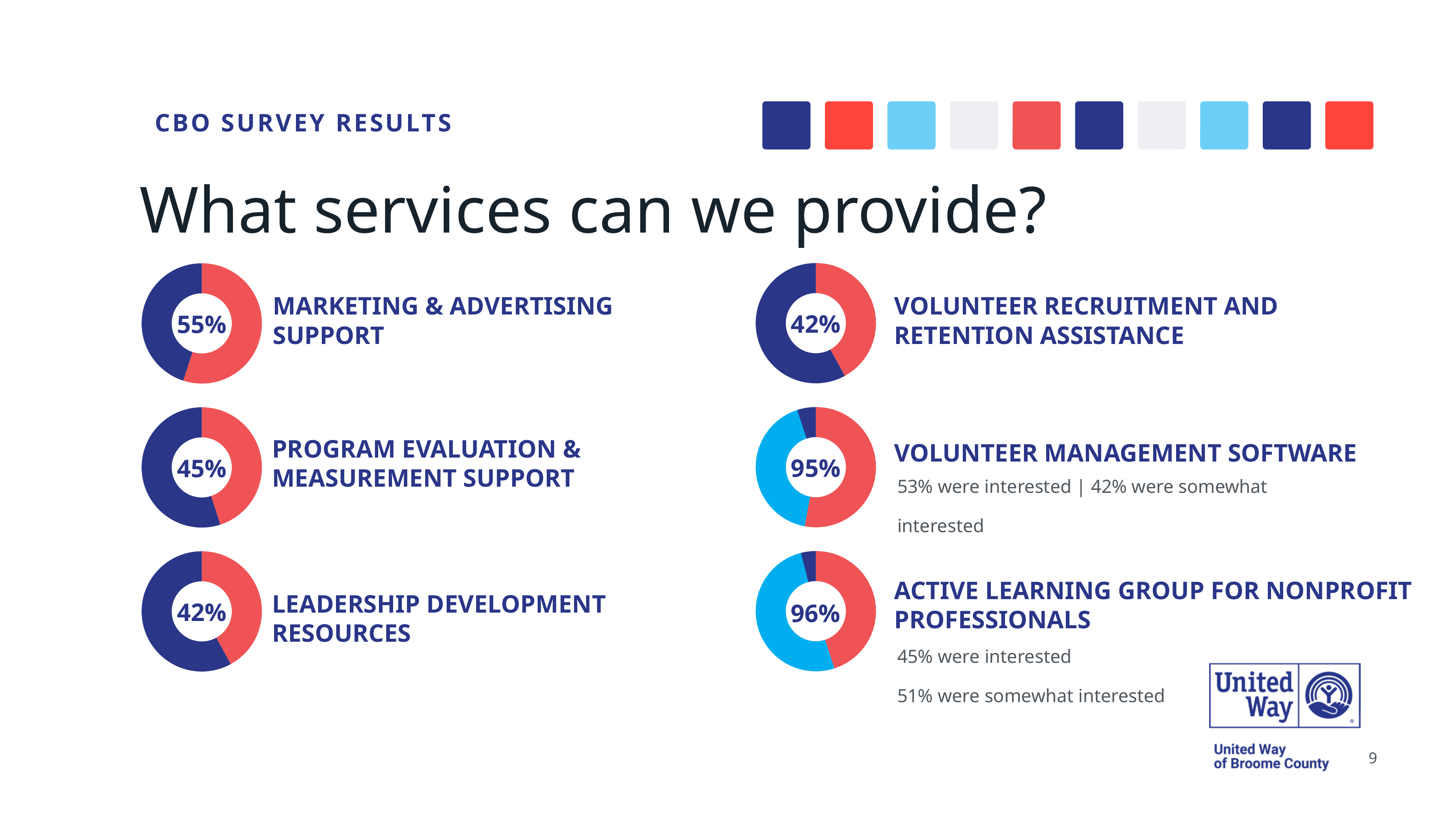
What percentage is shown in the centre of the Program Evaluation & Measurement Support donut chart? 45% For the Volunteer Management Software chart, what share of respondents were interested (as opposed to somewhat interested)? 53% What percentage is shown in the centre of the Volunteer Management Software donut chart? 95% Which has a larger percentage: Volunteer Management Software or Active Learning Group for Nonprofit Professionals? Active Learning Group for Nonprofit Professionals What is the difference between the percentage for Marketing & Advertising Support and the percentage for Program Evaluation & Measurement Support? 10% What kind of chart is used to show the percentage for each service on the slide? Donut chart What percentage is shown in the centre of the Marketing & Advertising Support donut chart? 55% What percentage is shown in the centre of the Volunteer Recruitment and Retention Assistance donut chart? 42% What percentage is shown in the centre of the Leadership Development Resources donut chart? 42% What percentage is shown in the centre of the Active Learning Group for Nonprofit Professionals donut chart? 96% Which service has the highest percentage shown in its donut chart? Active Learning Group for Nonprofit Professionals How many donut charts are shown on the slide? 6